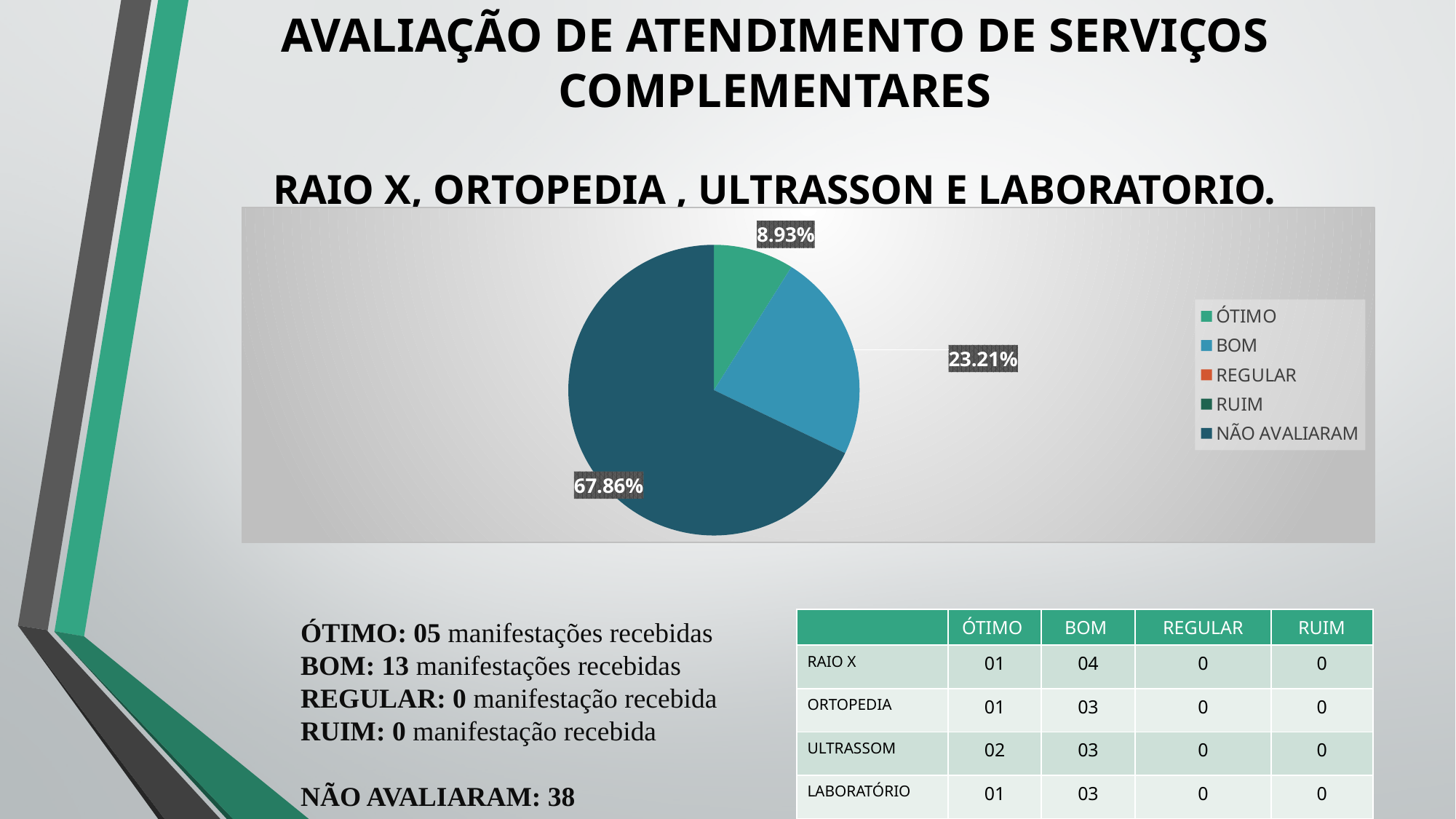
Which slice is larger in the pie chart, BOM or ÓTIMO? BOM How many slices with data labels are visible in the pie chart? 3 What is the difference in percentage points between the NÃO AVALIARAM slice and the BOM slice? 44.65% What type of chart is shown on the slide? pie chart What percentage of the pie chart corresponds to NÃO AVALIARAM? 67.86% Of the slices visible in the pie chart, which is the smallest? ÓTIMO Which category has the largest slice in the pie chart? NÃO AVALIARAM What percentage of the pie chart corresponds to ÓTIMO? 8.93% What is the difference in percentage points between the BOM slice and the ÓTIMO slice? 14.28% What percentage of the pie chart corresponds to BOM? 23.21% What colour does the legend use for ÓTIMO? green How many entries does the legend of the pie chart list? 5